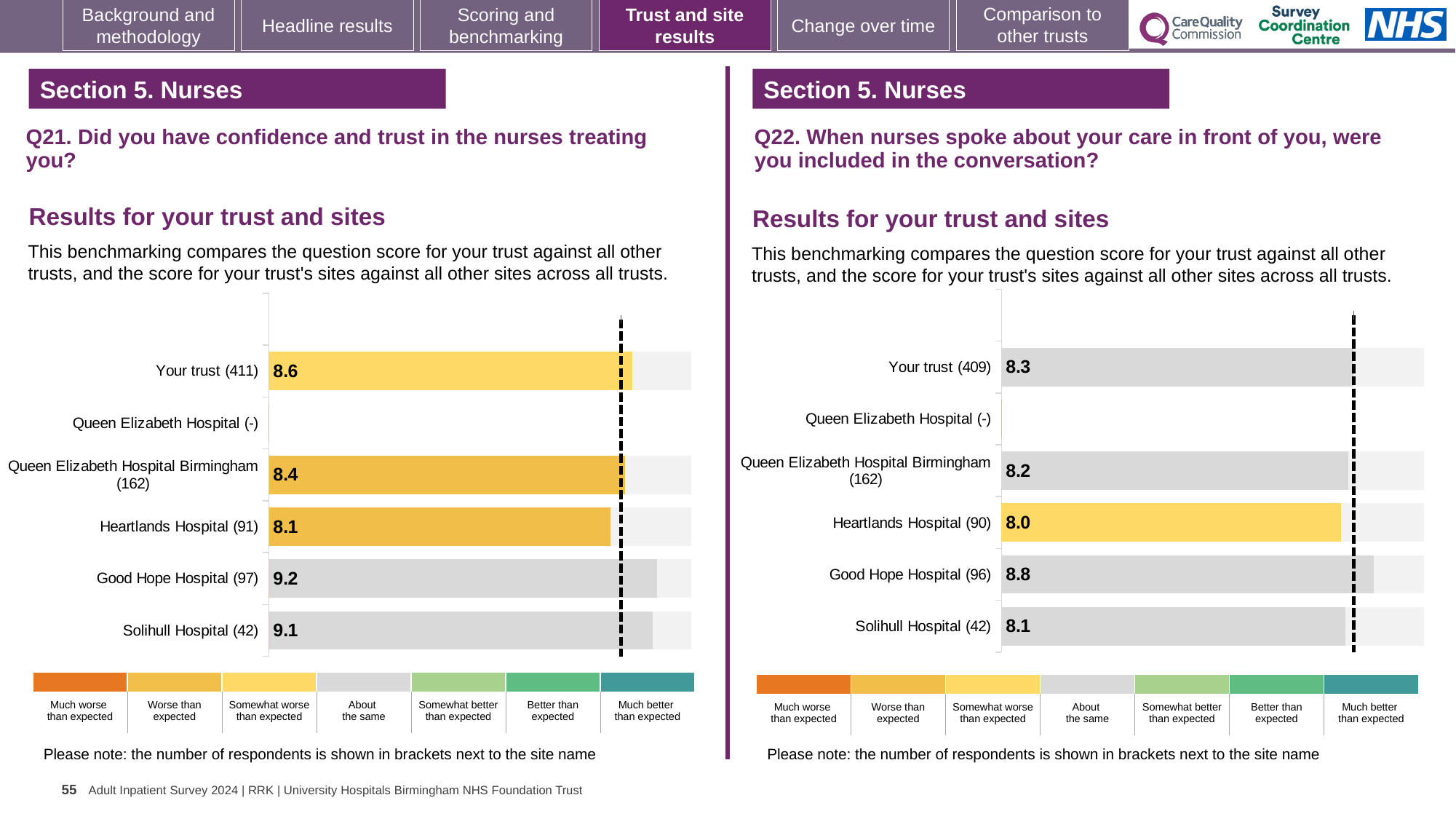
In the Q21 chart on the left, which site has the highest score? Good Hope Hospital (97) In the Q22 chart on the right, how many site or trust categories are listed on the vertical axis? 6 In the Q21 chart on the left, what is the score for Your trust (411)? 8.6 In the Q22 chart on the right, which is larger, the score for Queen Elizabeth Hospital Birmingham (162) or Solihull Hospital (42)? Queen Elizabeth Hospital Birmingham (162) What kind of chart is used for the Q21 results on the left? Bar chart In the Q22 chart on the right, what is the difference between the scores for Good Hope Hospital (96) and Your trust (409)? 0.5 In the Q22 chart on the right, what is the score for Heartlands Hospital (90)? 8.0 In the Q21 chart on the left, what is the score for Good Hope Hospital (97)? 9.2 In the Q22 chart on the right, what is the score for Your trust (409)? 8.3 In the Q21 chart on the left, which site has the lowest score? Heartlands Hospital (91) In the Q21 chart on the left, what is the difference between the scores for Solihull Hospital (42) and Heartlands Hospital (91)? 1.0 In the Q22 chart on the right, which site has the highest score? Good Hope Hospital (96)